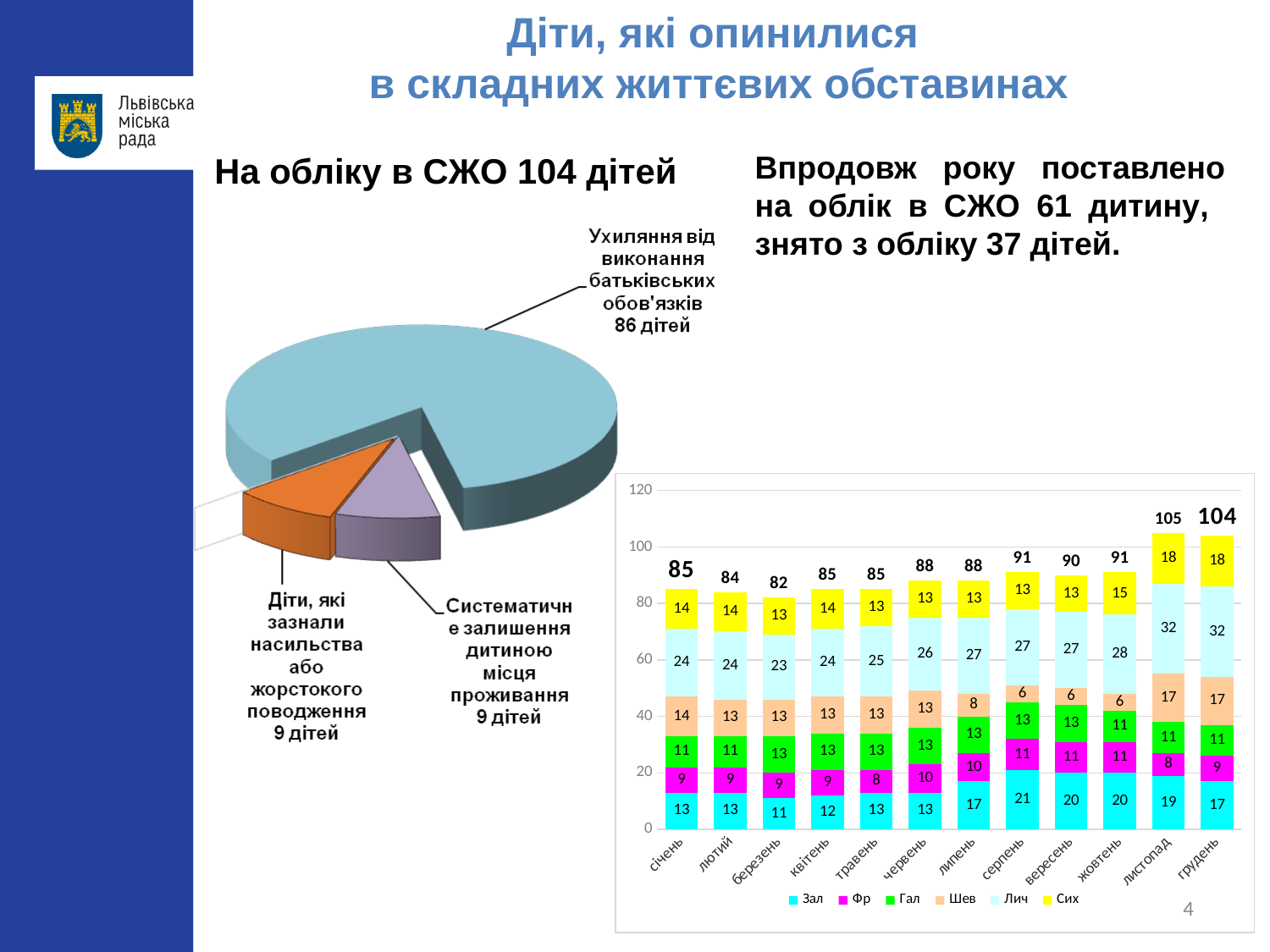
In the stacked bar chart on the right, what is the difference between the totals for листопад and жовтень? 14 In the stacked bar chart on the right, is the total for грудень greater or less than 100? greater In the pie chart on the left, how many children are in the slice 'Ухиляння від виконання батьківських обов'язків'? 86 дітей In the stacked bar chart on the right, which month has the lowest total? березень In the pie chart on the left, which category has the largest slice? Ухиляння від виконання батьківських обов'язків In the stacked bar chart on the right, how many series does the legend list? 6 In the stacked bar chart on the right, what is the value of the Зал series for серпень? 21 In the pie chart on the left, how many slices are there? 3 In the stacked bar chart on the right, what is the total for листопад? 105 What kind of chart is the chart on the left of the slide? Pie chart In the stacked bar chart on the right, what is the value of the Лич series for грудень? 32 In the stacked bar chart on the right, which is larger: the Шев value for січень or the Шев value for серпень? січень